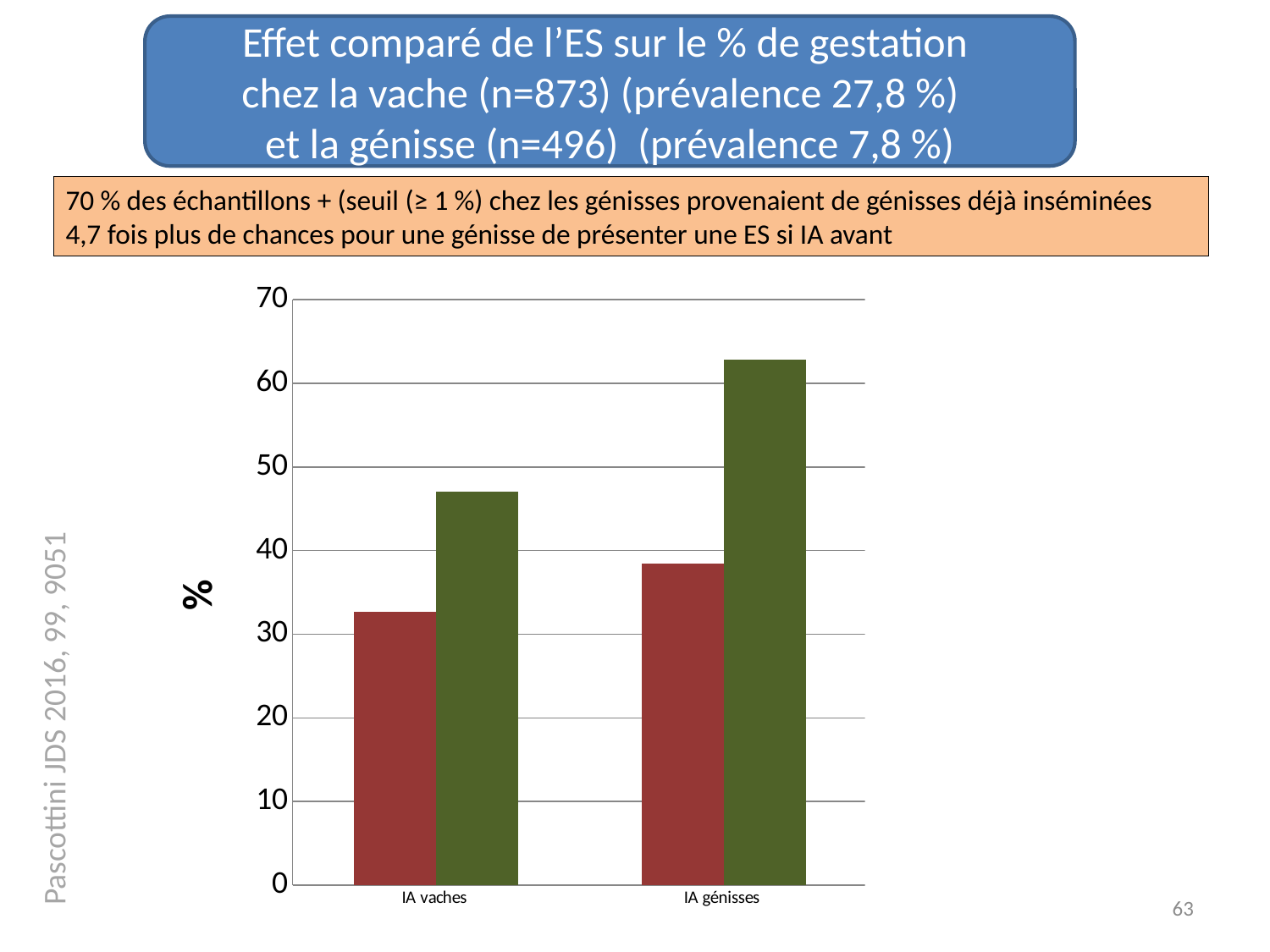
What kind of chart is shown on the slide? bar chart Which bar is the tallest in the chart? the green bar for IA génisses What is the label on the y axis of the chart? % Is the value of the red bar for IA vaches greater or less than 30? greater Do the values of both series rise or fall from IA vaches to IA génisses? rise How many categories are shown on the x axis of the chart? 2 Is the value of the green bar for IA vaches greater or less than 50? less For IA génisses, which bar is taller, the red one or the green one? the green one Which bar is the shortest in the chart? the red bar for IA vaches Is the value of the green bar for IA génisses greater or less than 60? greater What are the two category labels on the x axis? IA vaches, IA génisses For IA vaches, which bar is taller, the red one or the green one? the green one